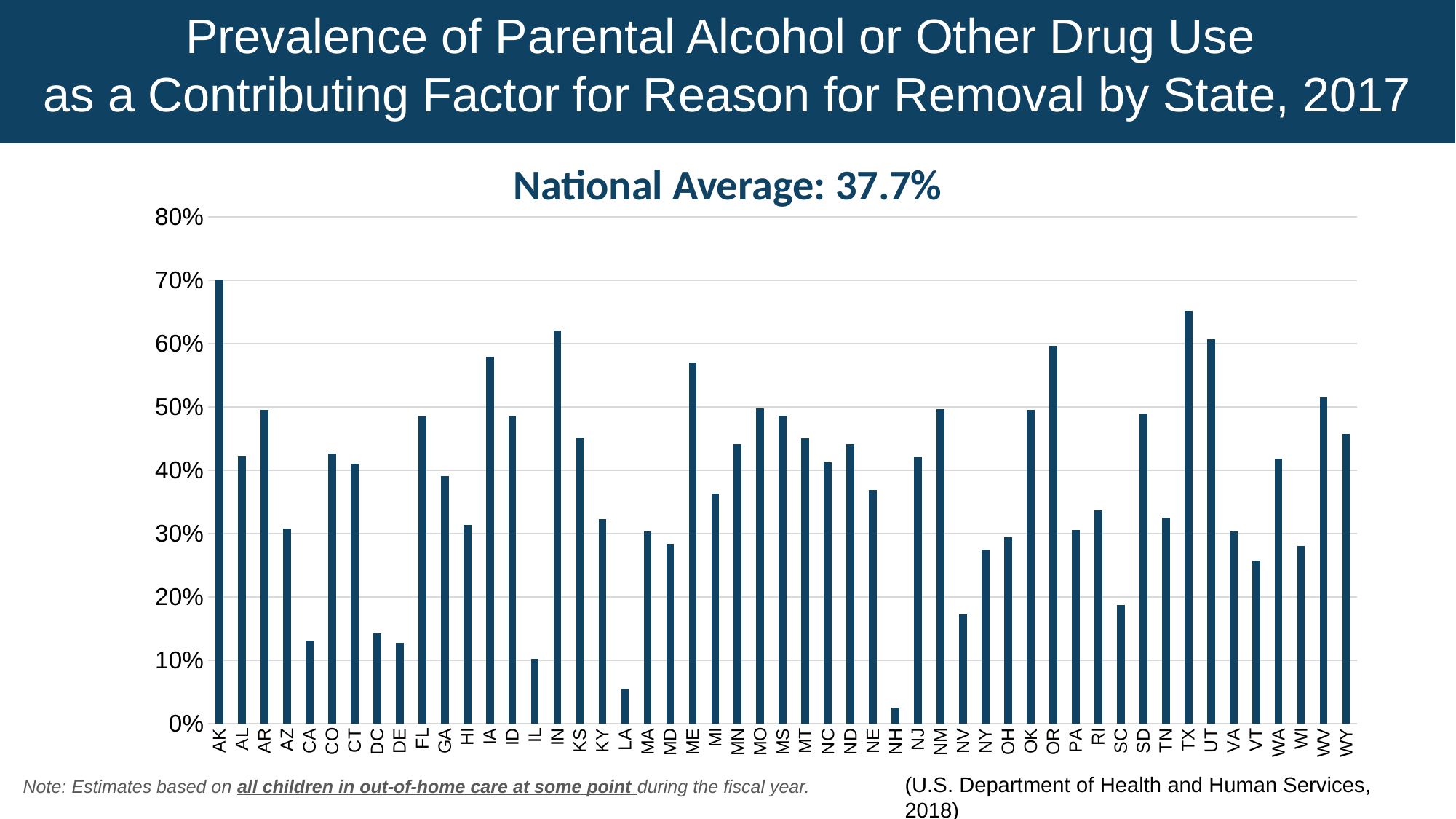
Is the value for AK greater or less than 60%? greater Which has a higher value, TX or UT? TX What is the highest value shown on the y axis of the chart? 80% What type of chart is shown on the slide? bar chart Which has a higher value, NV or NY? NY How many states or jurisdictions are shown on the x axis of the chart? 51 What national average is stated above the chart? 37.7% Is the value for CA greater or less than 20%? less Is the value for WV greater or less than 50%? greater Which state has the lowest prevalence of parental alcohol or other drug use as a contributing factor for removal? NH Which state has the highest prevalence of parental alcohol or other drug use as a contributing factor for removal? AK